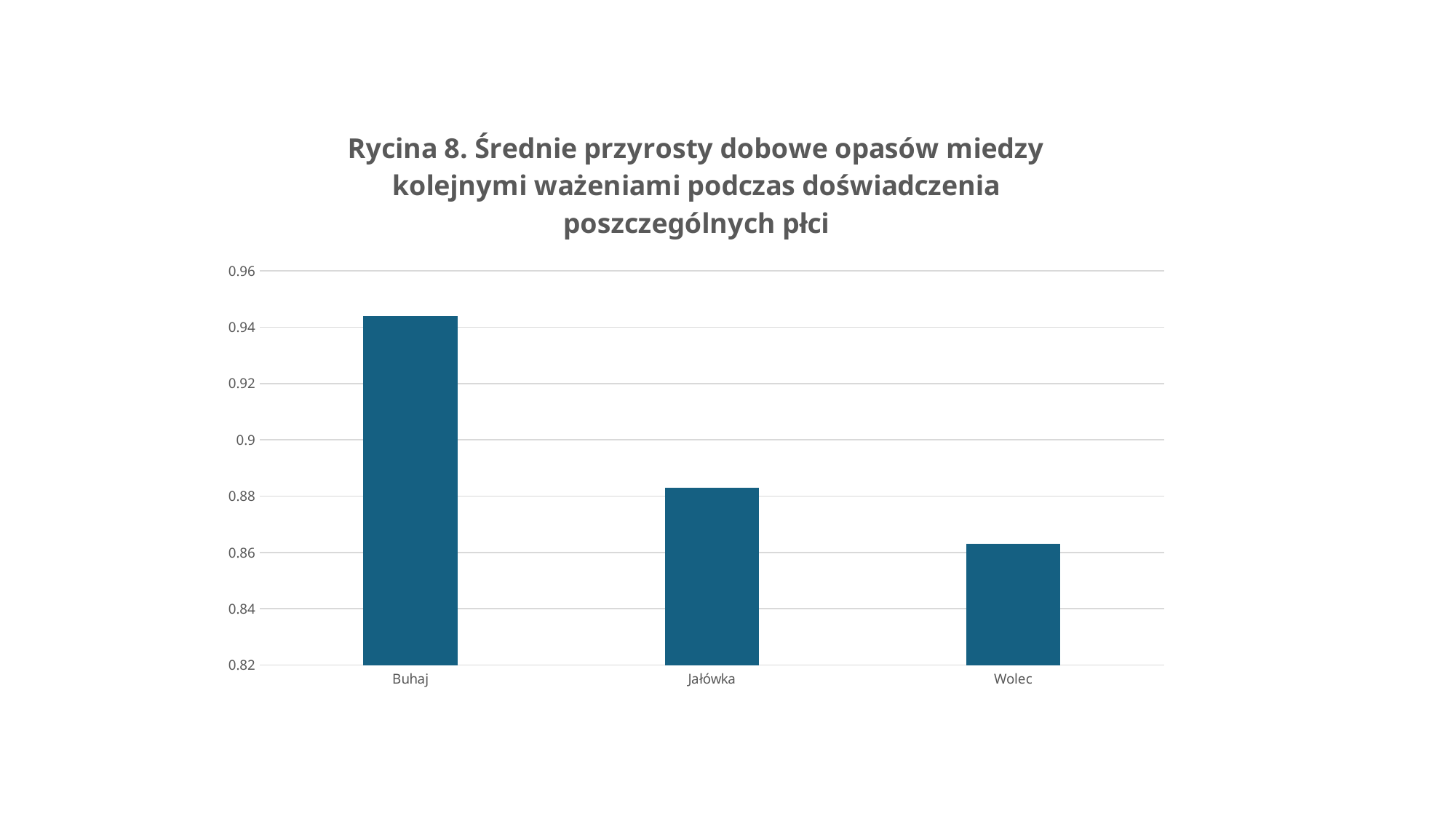
What is the figure number given in the chart title? Rycina 8 Which is larger, the value for Buhaj or the value for Jałówka? Buhaj Do the bar values rise or fall from left to right along the x axis? fall Is the value for Jałówka greater or less than 0.9? less Is the value for Wolec greater or less than 0.88? less Which category has the lowest bar in the chart? Wolec Which category has the highest bar in the chart? Buhaj Is the value for Buhaj greater or less than 0.92? greater What kind of chart is shown on the slide? bar chart How many categories are shown on the x axis of the chart? 3 Which is larger, the value for Jałówka or the value for Wolec? Jałówka